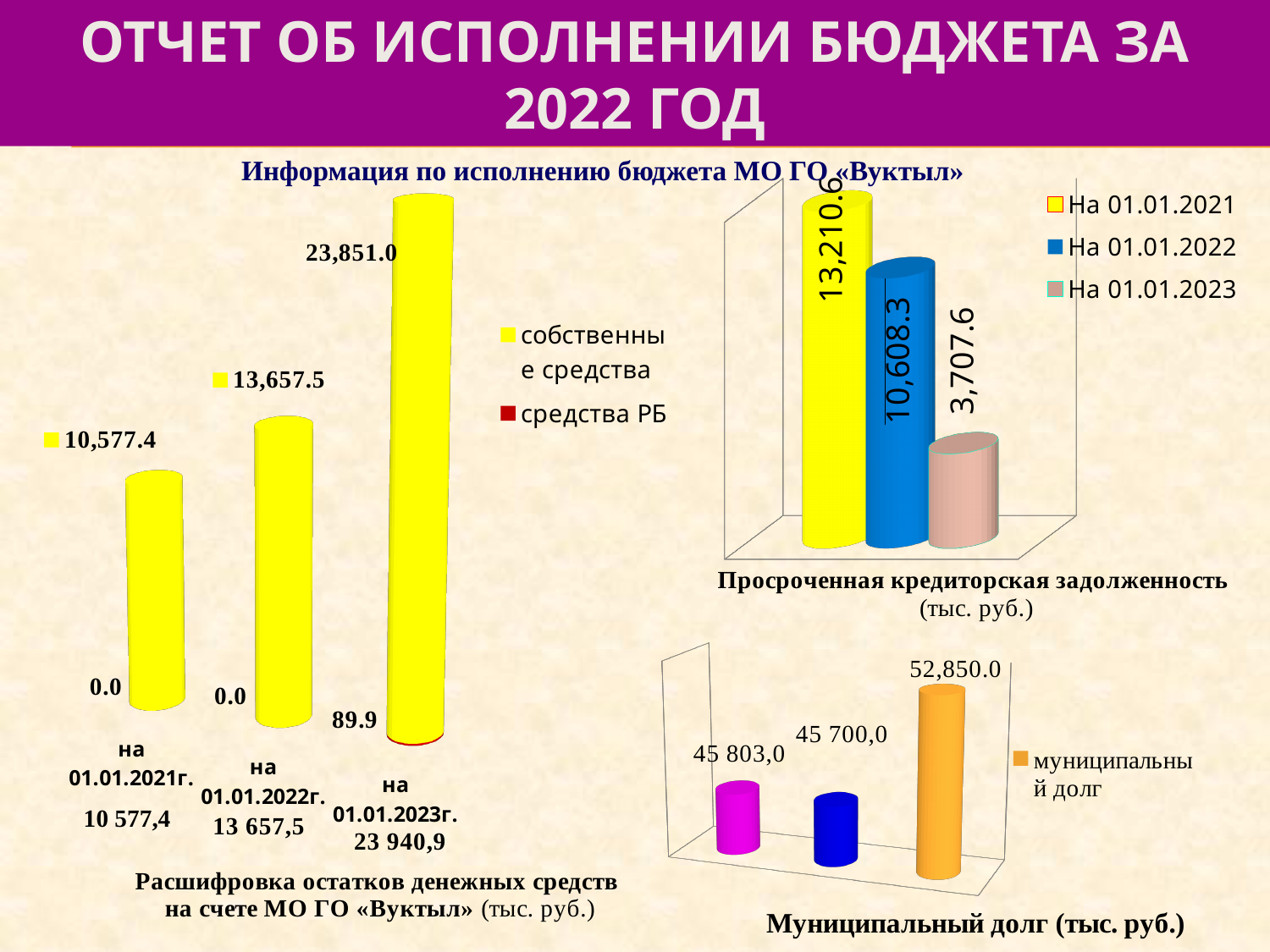
In the chart 'Расшифровка остатков денежных средств на счете МО ГО «Вуктыл»', what is the value of собственные средства на 01.01.2023г.? 23,851.0 In the chart 'Муниципальный долг (тыс. руб.)', how many bars are plotted? 3 In the chart 'Расшифровка остатков денежных средств на счете МО ГО «Вуктыл»', what is the value of средства РБ на 01.01.2023г.? 89.9 In the chart 'Расшифровка остатков денежных средств на счете МО ГО «Вуктыл»', do the values of собственные средства rise or fall from 01.01.2021 to 01.01.2023? rise In the chart 'Просроченная кредиторская задолженность (тыс. руб.)', what is the difference between the values for На 01.01.2021 and На 01.01.2023? 9,503.0 What kind of chart is 'Муниципальный долг (тыс. руб.)'? bar chart In the chart 'Расшифровка остатков денежных средств на счете МО ГО «Вуктыл»', what is the difference between собственные средства на 01.01.2022г. and на 01.01.2021г.? 3,080.1 In the chart 'Просроченная кредиторская задолженность (тыс. руб.)', which date has the lowest value? На 01.01.2023 In the chart 'Расшифровка остатков денежных средств на счете МО ГО «Вуктыл»', how many series does the legend list? 2 In the chart 'Просроченная кредиторская задолженность (тыс. руб.)', what is the value for На 01.01.2022? 10,608.3 In the chart 'Муниципальный долг (тыс. руб.)', what is the highest value shown? 52,850.0 In the chart 'Расшифровка остатков денежных средств на счете МО ГО «Вуктыл»', what is the value of собственные средства на 01.01.2021г.? 10,577.4